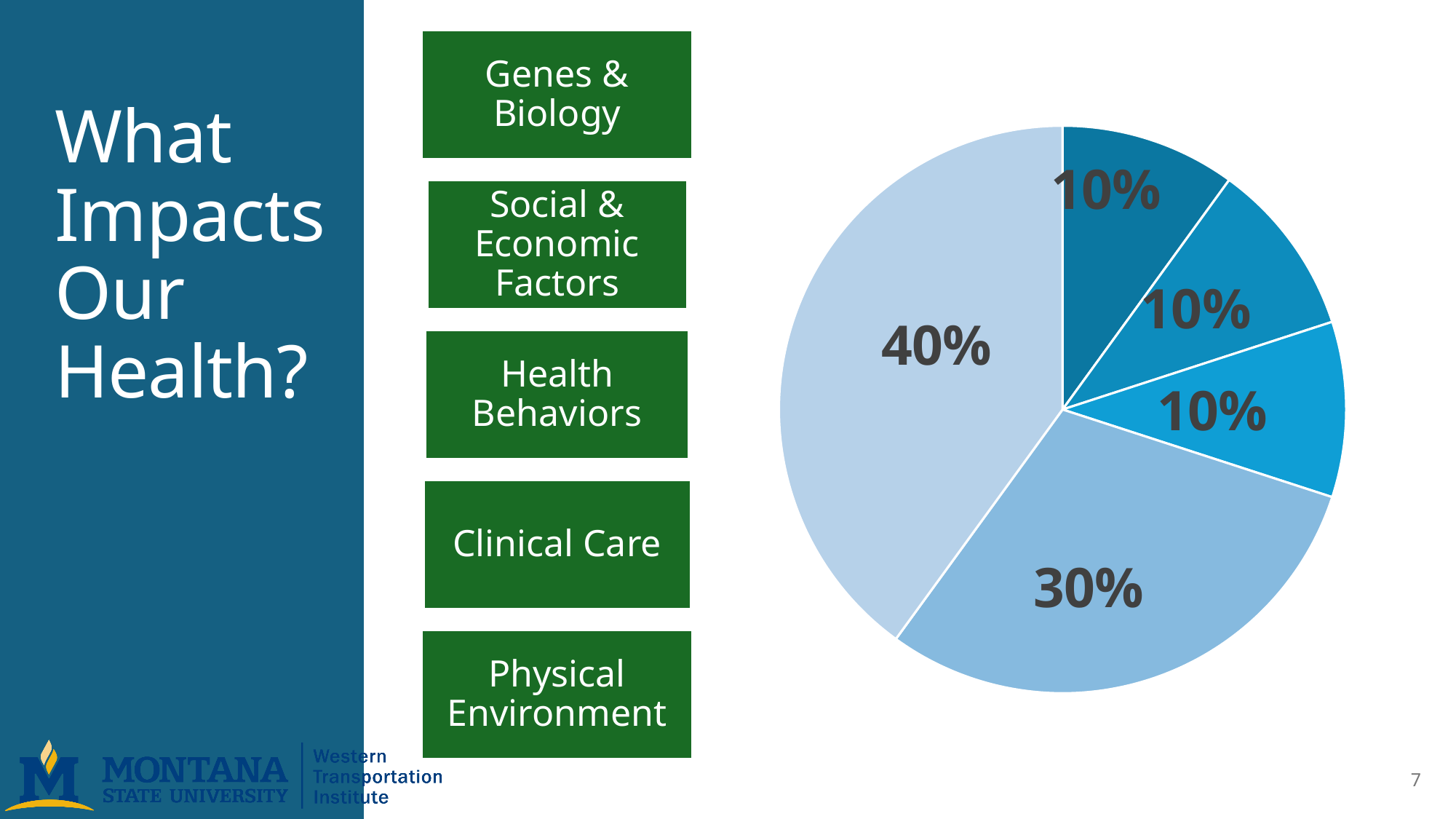
Which is larger: the 30% slice or the 40% slice? the 40% slice What is the combined share of the three slices labeled 10%? 30% What colour is the largest (40%) slice of the pie chart? light blue Does the pie chart include a legend? No How many slices in the pie chart are labeled 10%? 3 What kind of chart is shown on the slide? pie chart What is the share of the largest slice in the pie chart? 40% How many slices does the pie chart have? 5 What is the difference in percentage points between the largest slice (40%) and the second-largest slice (30%)? 10 percentage points What is the share of the second-largest slice in the pie chart? 30% What is the share of the smallest slice in the pie chart? 10%